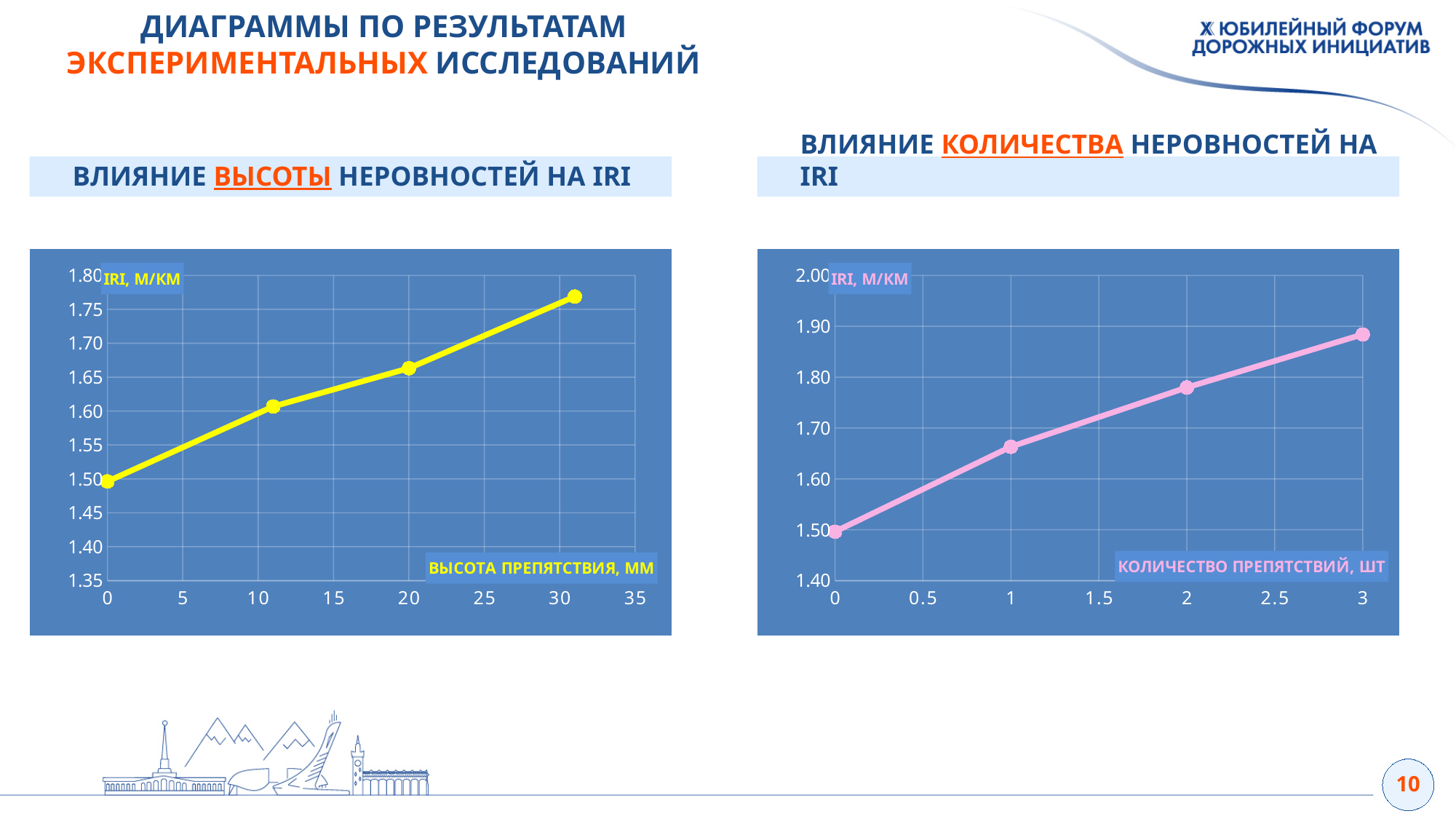
In the right chart (ВЛИЯНИЕ КОЛИЧЕСТВА НЕРОВНОСТЕЙ НА IRI), is the IRI value for 3 obstacles greater or less than 1.80? greater What type of chart is the left chart titled 'ВЛИЯНИЕ ВЫСОТЫ НЕРОВНОСТЕЙ НА IRI'? Line chart In the left chart (ВЛИЯНИЕ ВЫСОТЫ НЕРОВНОСТЕЙ НА IRI), is the IRI value at an obstacle height of 0 mm greater or less than 1.55? less In the right chart (ВЛИЯНИЕ КОЛИЧЕСТВА НЕРОВНОСТЕЙ НА IRI), does IRI rise or fall as the number of obstacles increases? Rises In the right chart (ВЛИЯНИЕ КОЛИЧЕСТВА НЕРОВНОСТЕЙ НА IRI), is the IRI value for 1 obstacle greater or less than 1.60? greater What is the x-axis label of the left chart (ВЛИЯНИЕ ВЫСОТЫ НЕРОВНОСТЕЙ НА IRI)? ВЫСОТА ПРЕПЯТСТВИЯ, ММ What is the x-axis label of the right chart (ВЛИЯНИЕ КОЛИЧЕСТВА НЕРОВНОСТЕЙ НА IRI)? КОЛИЧЕСТВО ПРЕПЯТСТВИЙ, ШТ What type of chart is the right chart titled 'ВЛИЯНИЕ КОЛИЧЕСТВА НЕРОВНОСТЕЙ НА IRI'? Line chart In the left chart (ВЛИЯНИЕ ВЫСОТЫ НЕРОВНОСТЕЙ НА IRI), does IRI rise or fall as the obstacle height increases? Rises In the right chart (ВЛИЯНИЕ КОЛИЧЕСТВА НЕРОВНОСТЕЙ НА IRI), how many data points are plotted on the line? 4 In the left chart (ВЛИЯНИЕ ВЫСОТЫ НЕРОВНОСТЕЙ НА IRI), how many data points are plotted on the line? 4